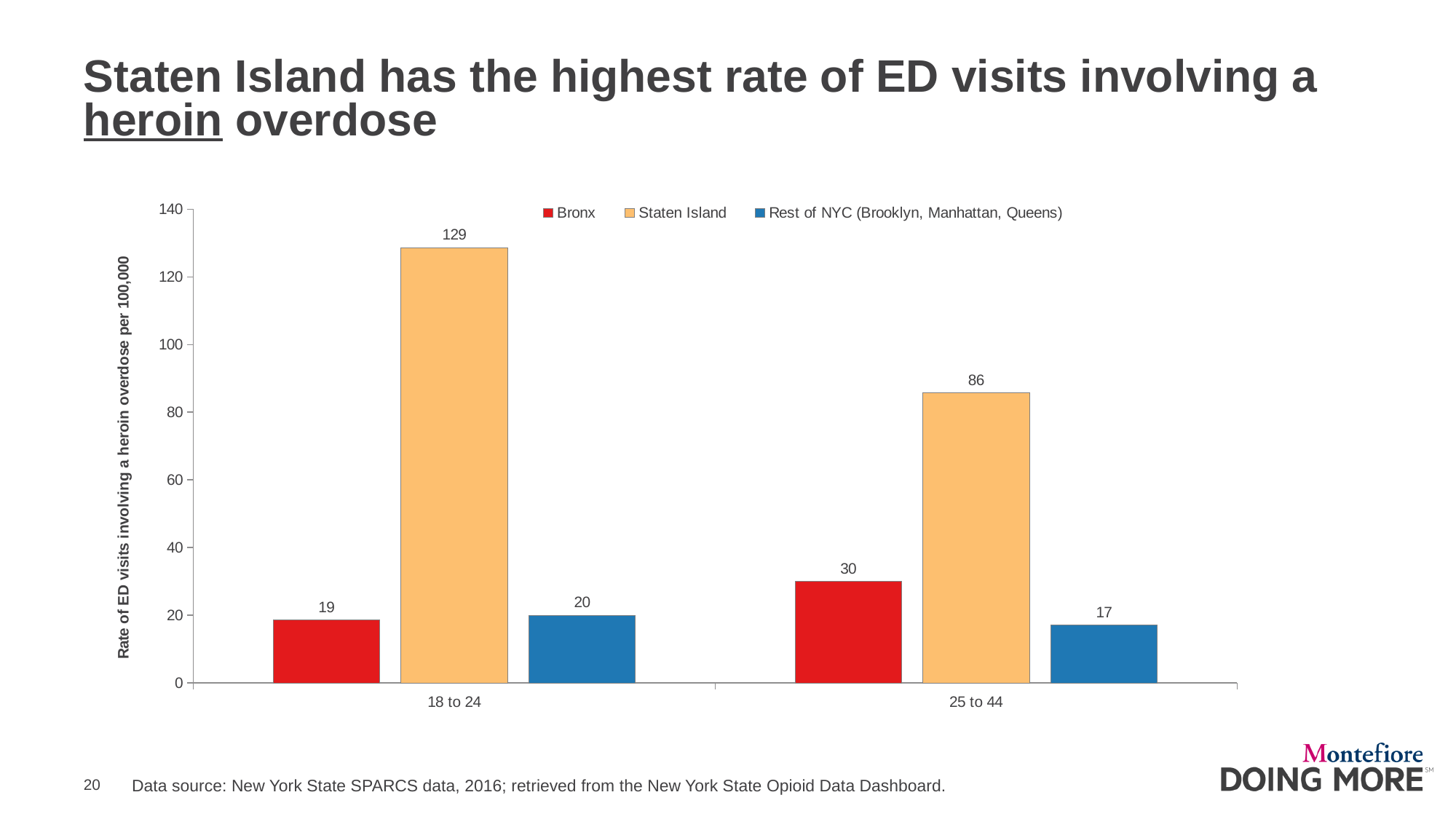
What is the value for Rest of NYC (Brooklyn, Manhattan, Queens) in the 18 to 24 age group? 20 What colour are the Staten Island bars? Orange What is the value for the Bronx in the 25 to 44 age group? 30 What kind of chart is shown on the slide? Bar chart What is the difference between the Staten Island values for the 18 to 24 and 25 to 44 age groups? 43 What is the difference between the Staten Island and Bronx values in the 18 to 24 age group? 110 Which is larger: the Bronx value for 18 to 24 or the Bronx value for 25 to 44? 25 to 44 How many age groups are shown on the x axis? 2 How many series does the legend list? 3 What is the rate of ED visits involving a heroin overdose for Staten Island in the 18 to 24 age group? 129 Which series has the highest value in the 25 to 44 age group? Staten Island Which series has the lowest value in the 25 to 44 age group? Rest of NYC (Brooklyn, Manhattan, Queens)